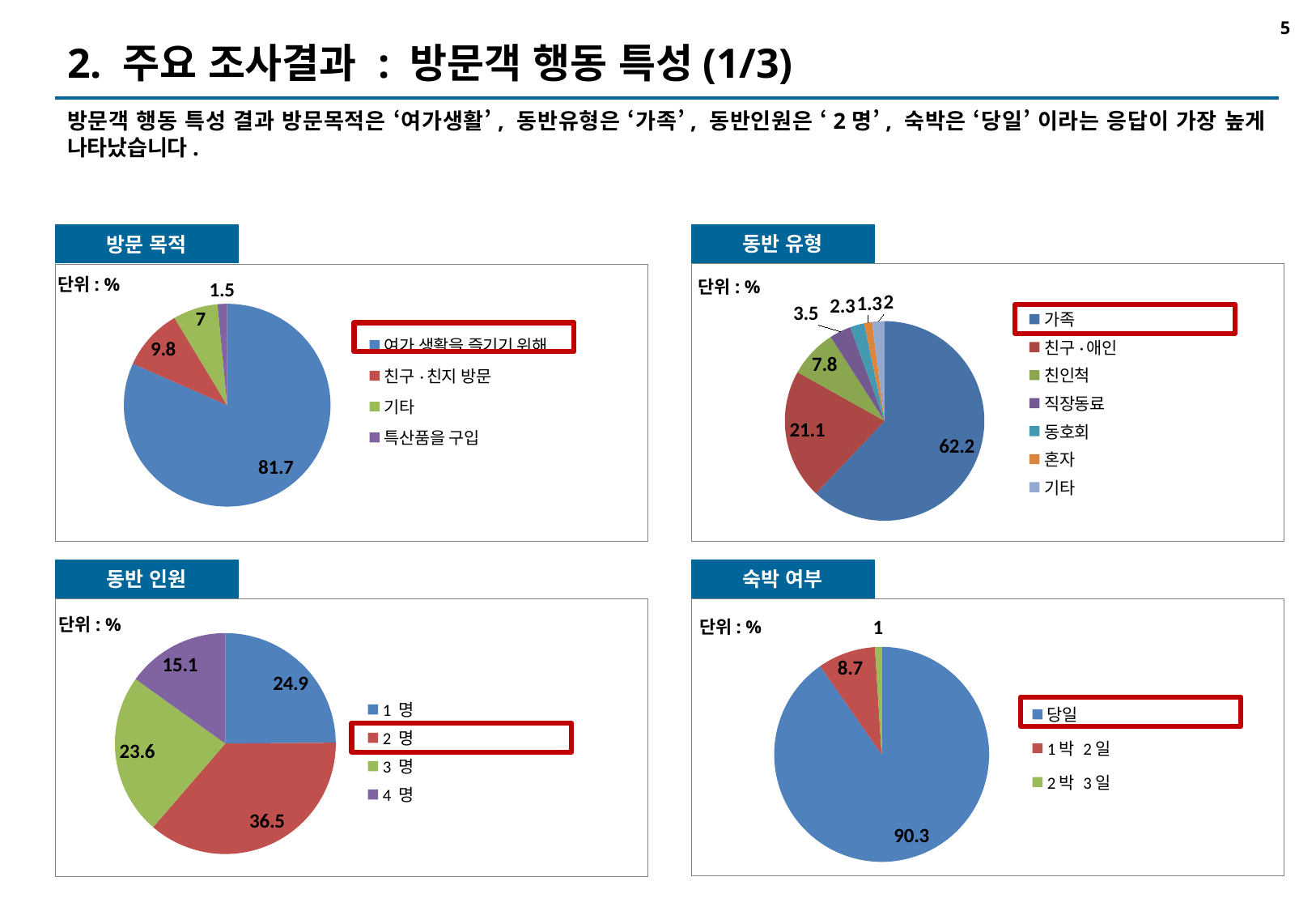
In the 방문 목적 chart, what is the difference between 여가 생활을 즐기기 위해 and 친구·친지 방문? 71.9 In the 동반 유형 chart, which category has the smallest share? 혼자 In the 방문 목적 chart, what is the value for 친구·친지 방문? 9.8 In the 동반 유형 chart, what is the value for 친인척? 7.8 What type of chart is the 숙박 여부 chart? Pie chart In the 동반 인원 chart, which is larger, 1 명 or 4 명? 1 명 How many categories does the legend of the 동반 유형 chart list? 7 In the 방문 목적 chart, which category has the largest share? 여가 생활을 즐기기 위해 What unit is shown for the values in the 방문 목적 chart? % In the 동반 인원 chart, what is the difference between 2 명 and 1 명? 11.6 In the 동반 인원 chart, what is the value for 3 명? 23.6 In the 숙박 여부 chart, what is the value for 1박 2일? 8.7